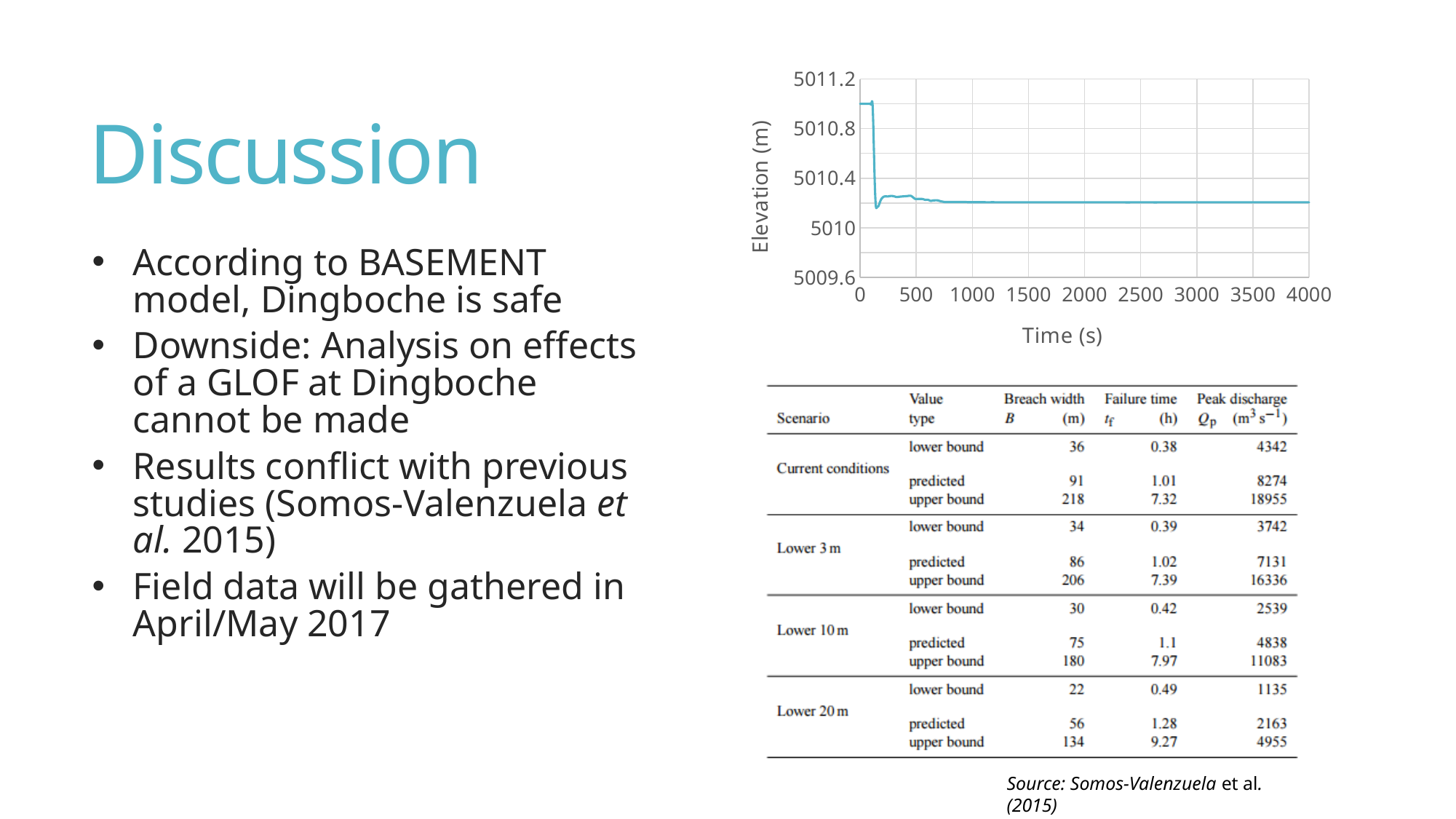
Is the elevation at 1000 s greater or less than 5010.8 m? less Is the elevation at 3000 s greater or less than 5010 m? greater Does the elevation in the line chart rise or fall over the first 500 seconds? fall Is the elevation at time 0 greater or less than 5010.8 m? greater What is the label of the x axis of the line chart? Time (s) What is the highest tick value shown on the x axis of the line chart? 4000 What is the label of the y axis of the line chart? Elevation (m) What kind of chart is shown on the slide? line chart Which is higher in the line chart: the elevation at time 0 or the elevation at 4000 s? elevation at time 0